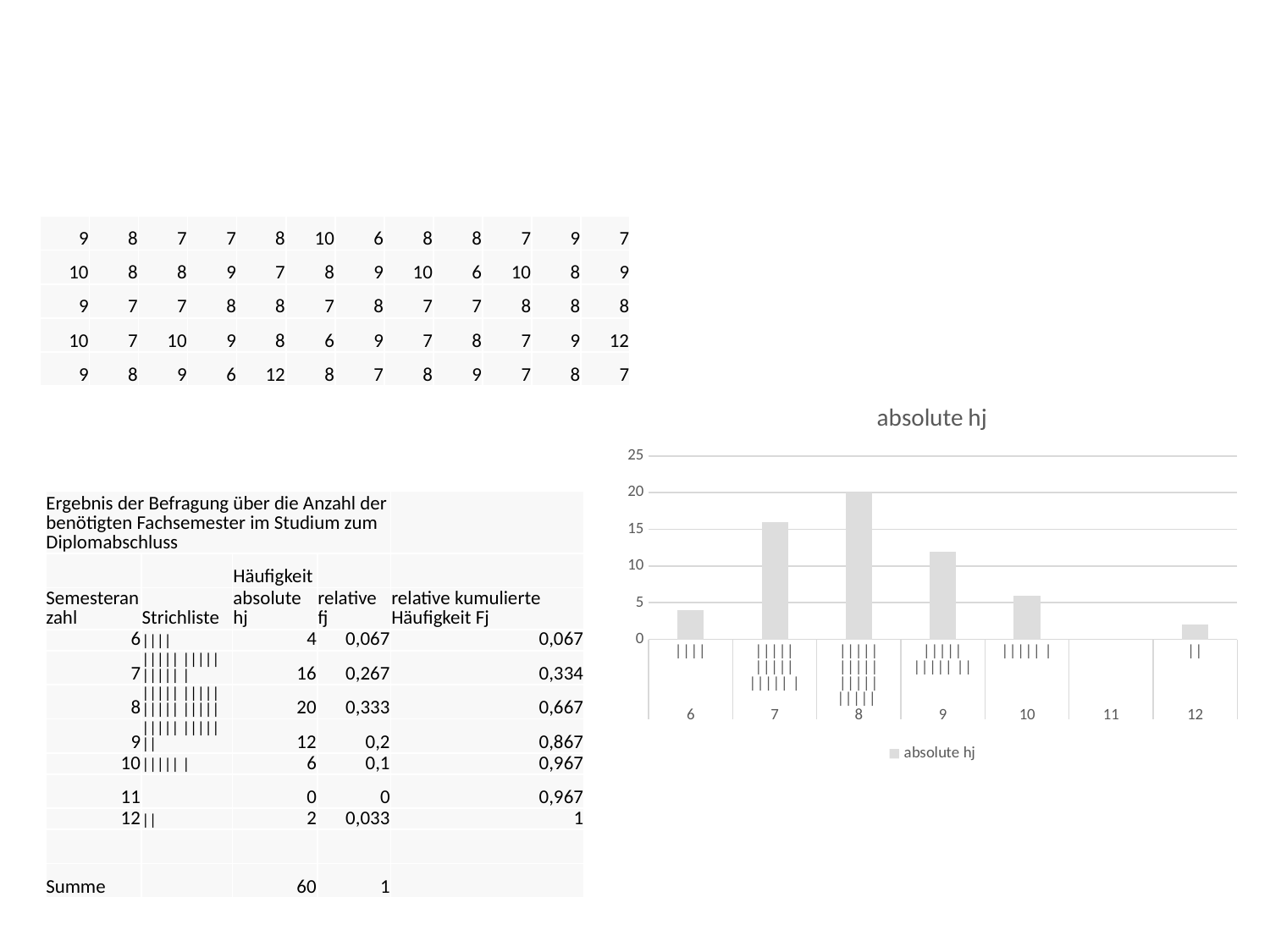
How many series does the chart legend list? 1 What kind of chart is shown on the slide? bar chart Which category has the highest bar in the chart? 8 Is the value for category 7 greater or less than 15? greater Which category has the lowest bar in the chart? 11 How many categories are shown on the x axis of the chart? 7 Is the value for category 9 greater or less than 10? greater What is the value of the bar for category 11? 0 What is the title of the chart? absolute hj Is the value for category 12 greater or less than 5? less Which bar is taller, category 7 or category 9? 7 What is the value of the bar for category 8? 20